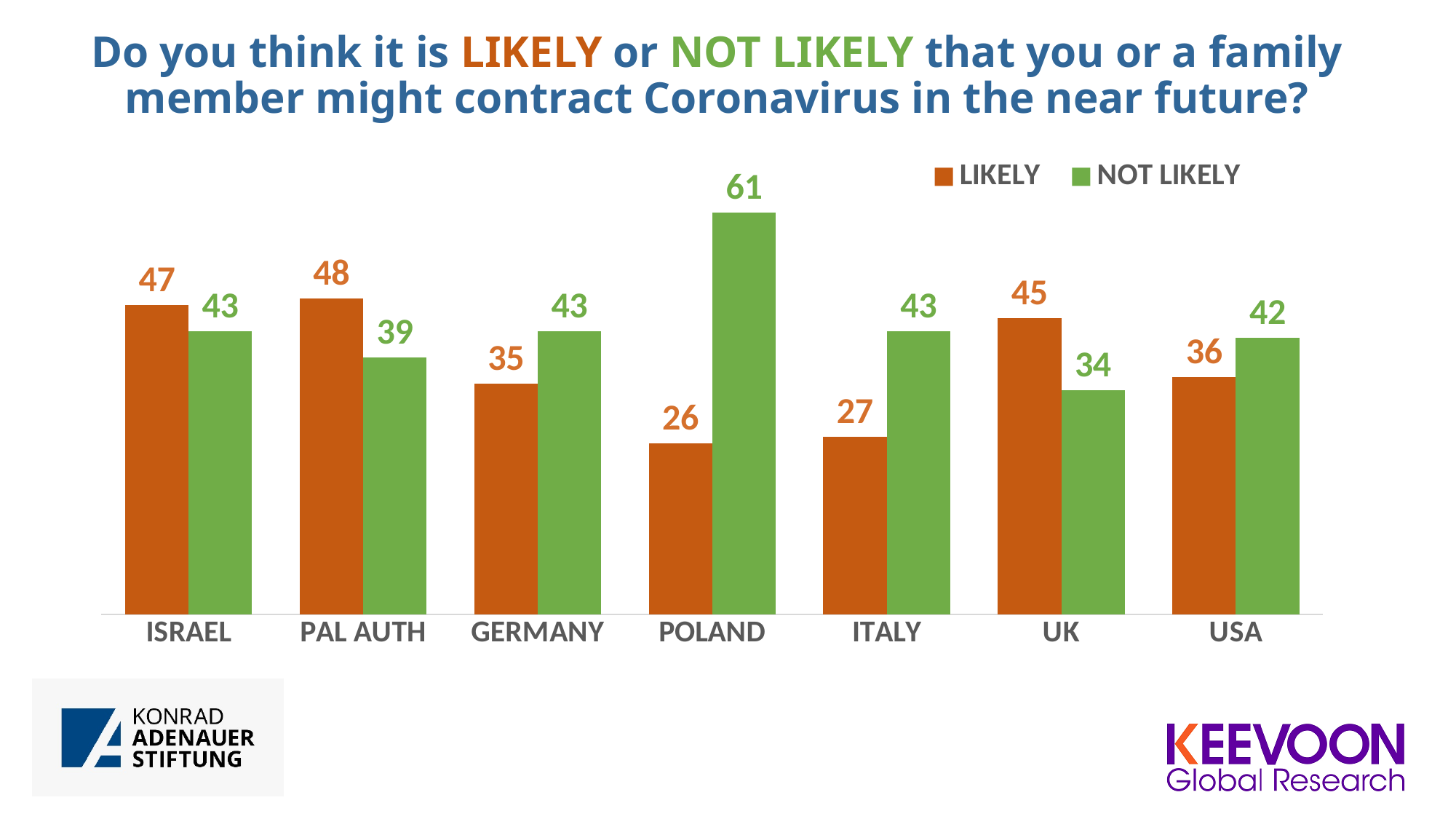
What is the LIKELY value for Poland? 26 What is the LIKELY value for Pal Auth? 48 What is the difference between the LIKELY values for Israel and Italy? 20 Which colour represents the NOT LIKELY series? Green What is the difference between the NOT LIKELY and LIKELY values for Poland? 35 What is the NOT LIKELY value for the UK? 34 Which country has the highest NOT LIKELY value? Poland Which country has the lowest LIKELY value? Poland How many countries are shown on the x axis? 7 How many series does the legend list? 2 Which is larger for Germany, the LIKELY value or the NOT LIKELY value? NOT LIKELY What kind of chart is shown on the slide? Bar chart